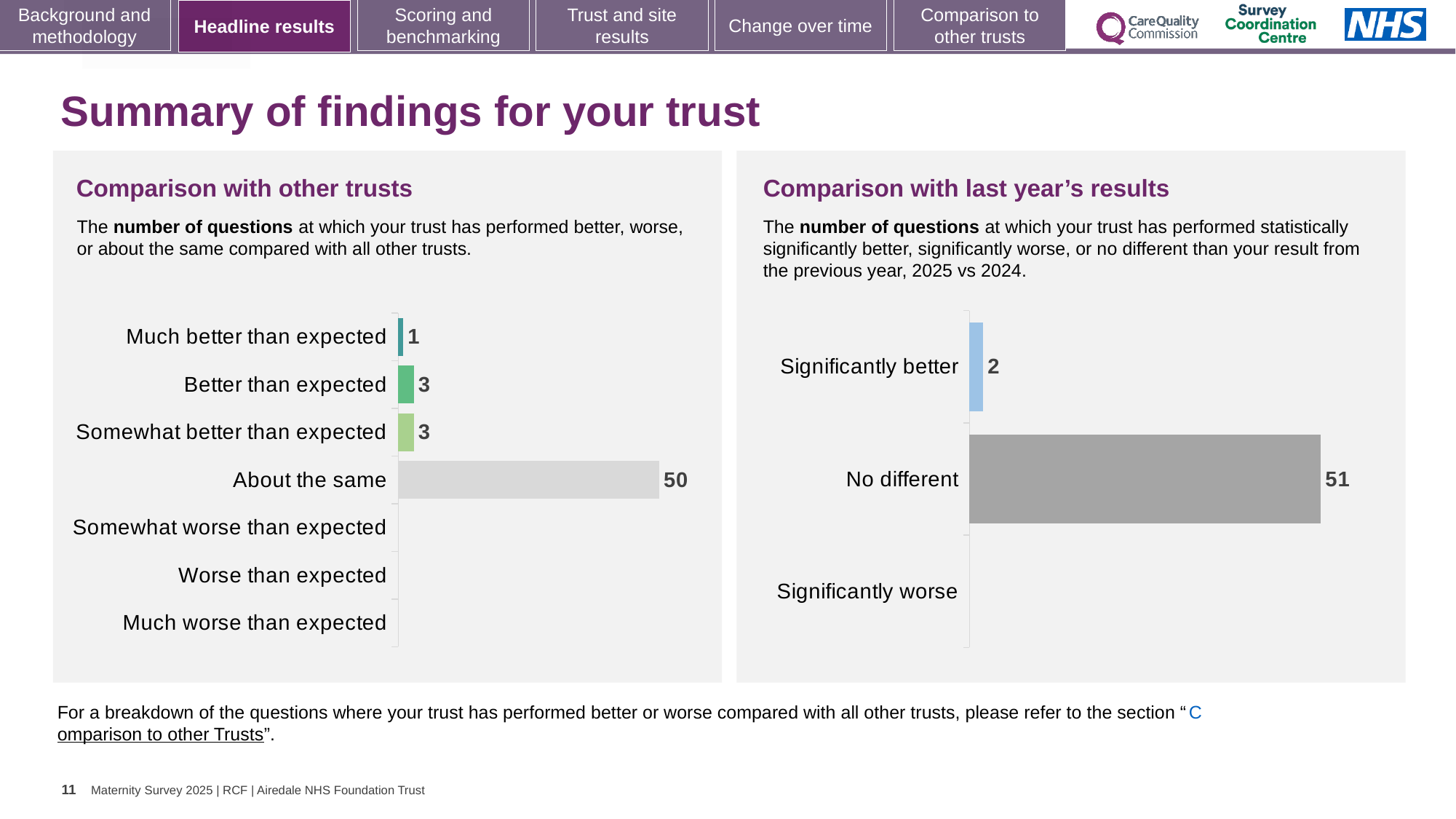
In the 'Comparison with last year's results' chart, what is the value for 'No different'? 51 What is the title of the chart on the right side of the slide? Comparison with last year's results In the 'Comparison with other trusts' chart, which is larger: 'Better than expected' or 'Much better than expected'? Better than expected In the 'Comparison with other trusts' chart, which category has the highest value? About the same In the 'Comparison with last year's results' chart, what is the value for 'Significantly better'? 2 In the 'Comparison with other trusts' chart, what is the value for 'Much better than expected'? 1 What type of chart is the 'Comparison with other trusts' chart? Bar chart In the 'Comparison with other trusts' chart, what is the difference between 'About the same' and 'Better than expected'? 47 In the 'Comparison with last year's results' chart, what is the difference between 'No different' and 'Significantly better'? 49 In the 'Comparison with last year's results' chart, how many categories are shown? 3 In the 'Comparison with other trusts' chart, how many categories are listed on the axis? 7 In the 'Comparison with other trusts' chart, how many questions are 'About the same'? 50